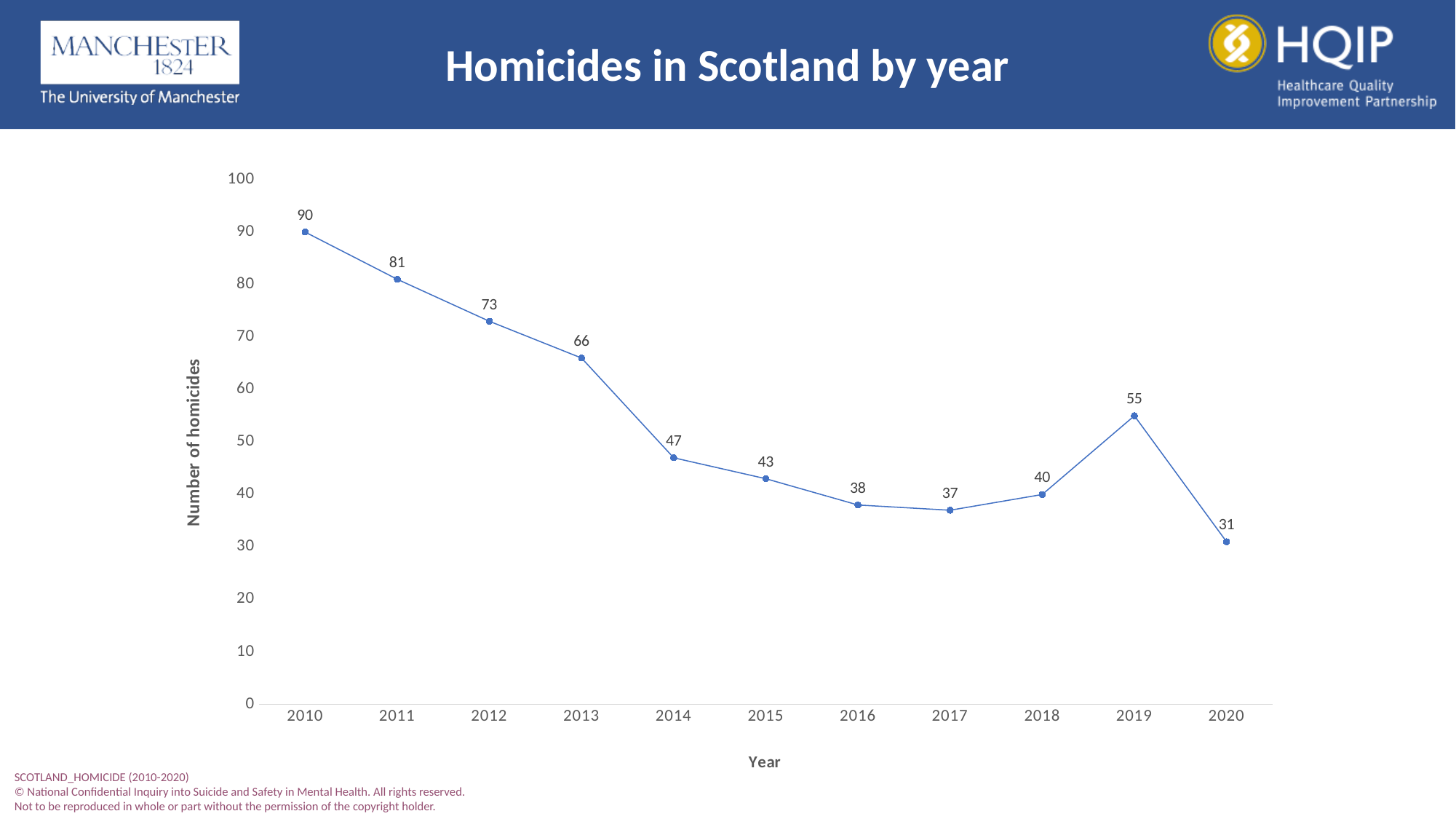
Is the number of homicides in 2012 greater or less than 70? greater What is the label of the y axis? Number of homicides What is the number of homicides in Scotland in 2014? 47 What is the difference in the number of homicides between 2018 and 2019? 15 What is the number of homicides in Scotland in 2019? 55 Which year has the highest number of homicides? 2010 What is the number of homicides in Scotland in 2010? 90 What kind of chart is shown on the slide? Line chart What is the difference in the number of homicides between 2010 and 2020? 59 Which year has the lowest number of homicides? 2020 Which year had more homicides, 2013 or 2015? 2013 How many years are plotted on the chart? 11